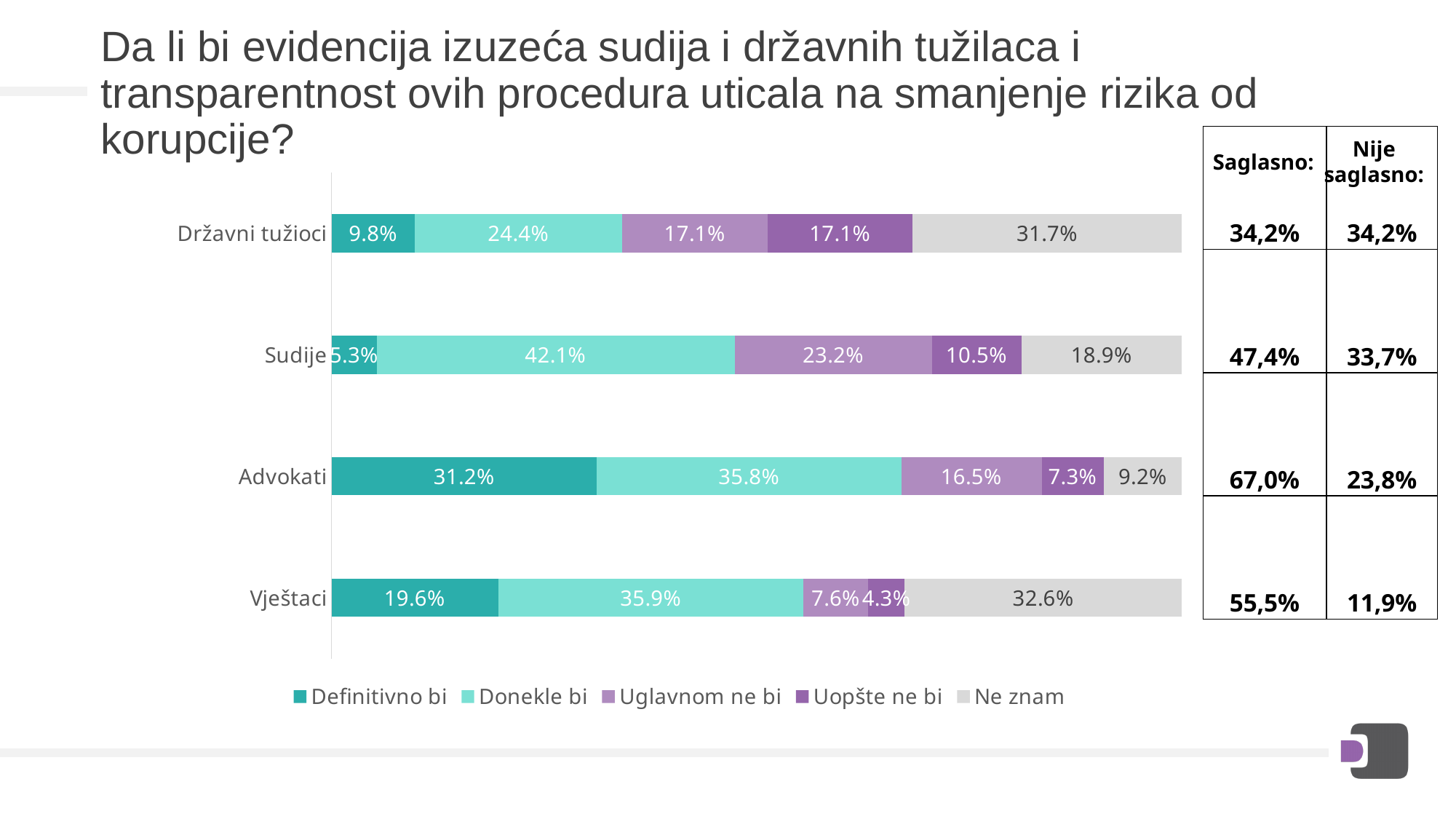
Which is larger: the "Donekle bi" value for Državni tužioci or for Vještaci? Vještaci How many categories are shown on the chart? 4 What kind of chart is shown on the slide? Stacked bar chart How many series does the legend list? 5 Which category has the lowest value for "Ne znam"? Advokati What is the value of "Uopšte ne bi" for Državni tužioci? 17.1% Which legend entry is shown in grey? Ne znam What is the difference between the "Definitivno bi" values for Advokati and Sudije? 25.9 percentage points What is the value of "Ne znam" for Vještaci? 32.6% What is the value of "Uglavnom ne bi" for Advokati? 16.5% Which category has the highest value for "Definitivno bi"? Advokati What is the value of "Donekle bi" for Sudije? 42.1%